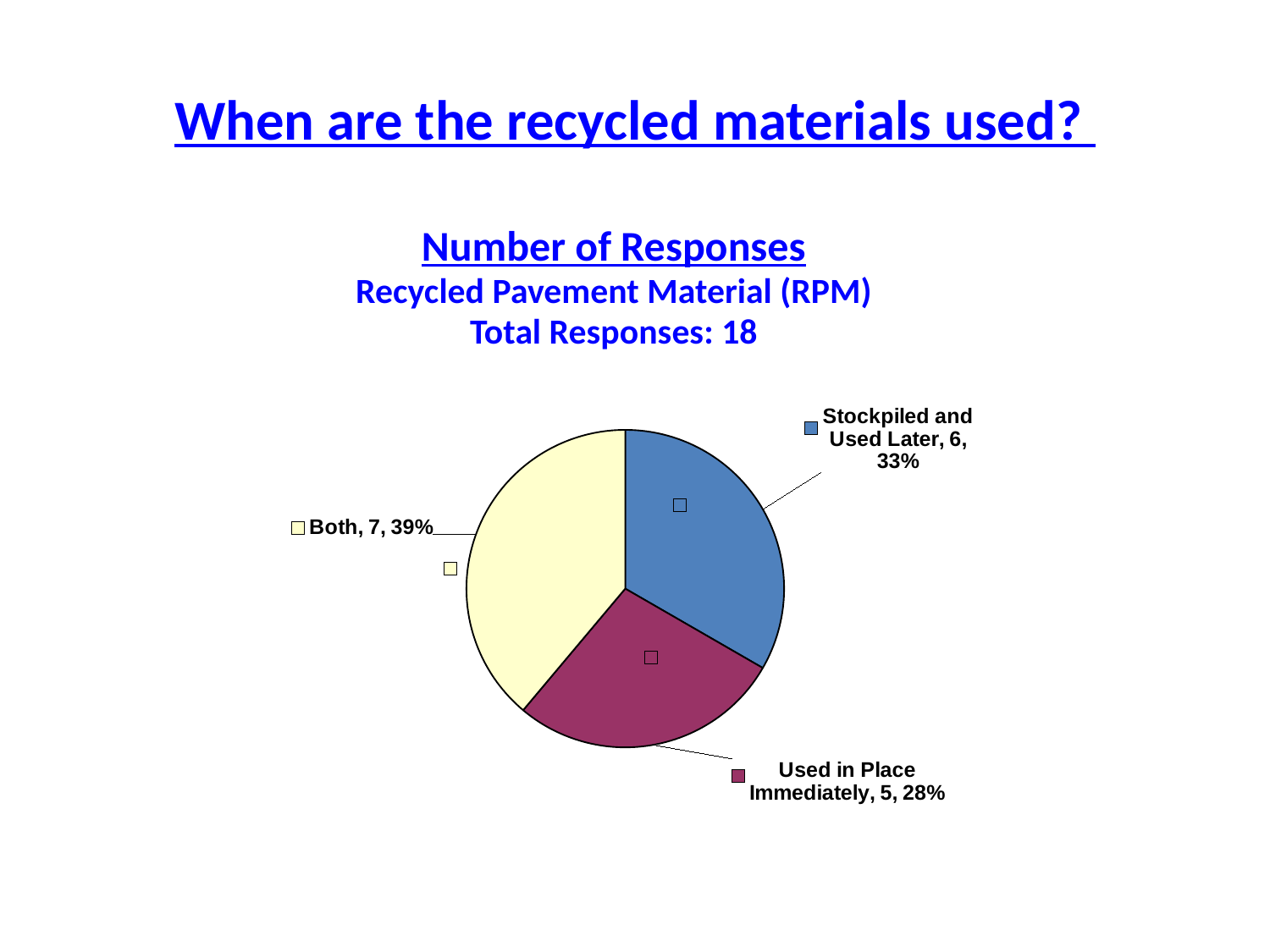
What kind of chart is shown on the slide? pie chart Which category has the most responses? Both What share of the pie does "Used in Place Immediately" represent? 28% How many responses are in the "Stockpiled and Used Later" slice? 6 What is the total number of responses shown on the slide? 18 What share of the pie does "Both" represent? 39% How many slices does the pie chart have? 3 What share of the pie does "Stockpiled and Used Later" represent? 33% How many responses are in the "Both" slice? 7 How many responses are in the "Used in Place Immediately" slice? 5 What is the difference in responses between "Both" and "Used in Place Immediately"? 2 Which category has the fewest responses? Used in Place Immediately